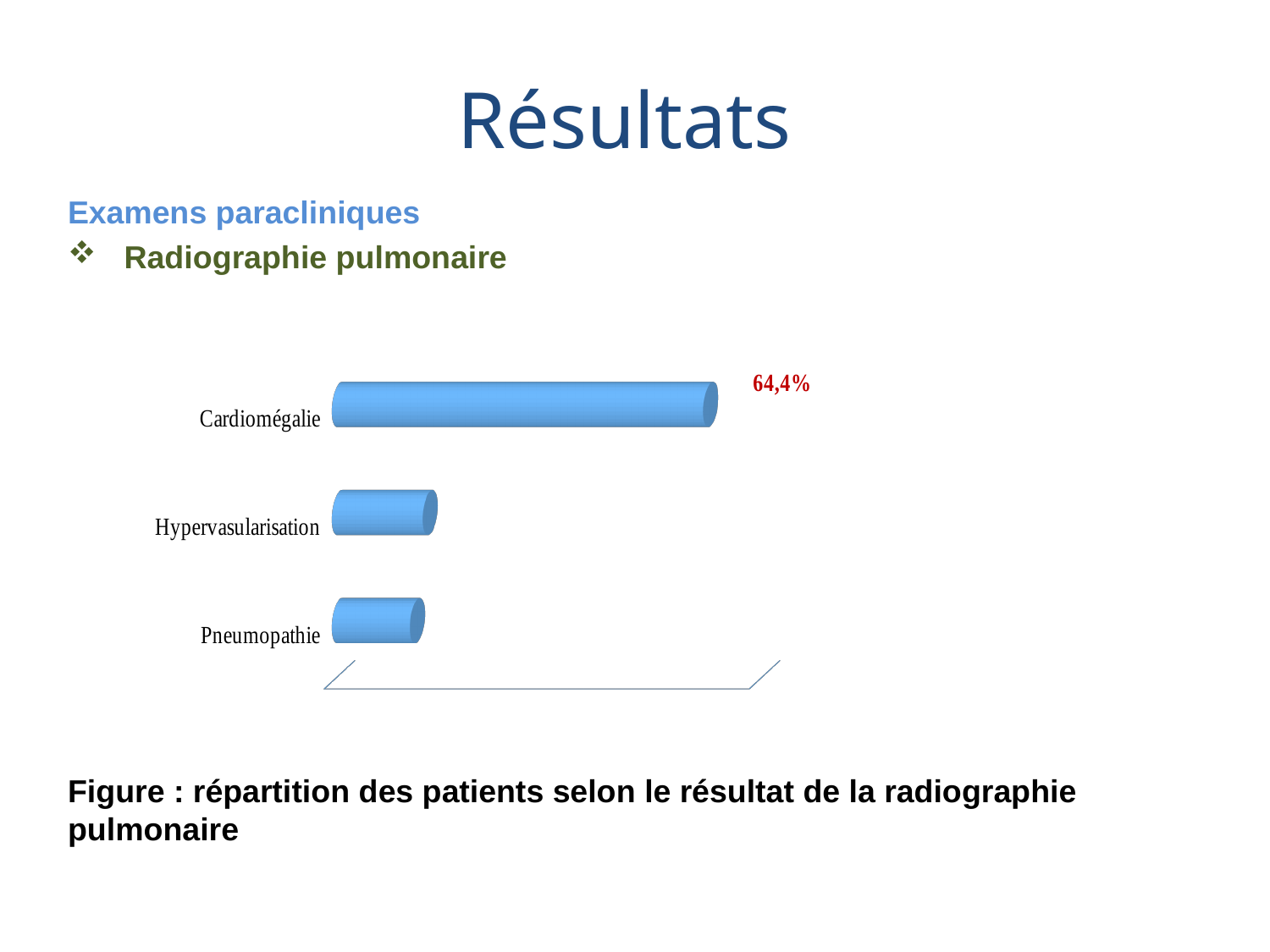
Which is larger, the value for Cardiomégalie or the value for Hypervasularisation? Cardiomégalie What colour are the bars in the chart? Blue Which is larger, the value for Cardiomégalie or the value for Pneumopathie? Cardiomégalie What is the value shown for Cardiomégalie? 64,4% Which category has the highest value? Cardiomégalie How many categories are shown in the chart? 3 Which category is listed at the top of the chart? Cardiomégalie What kind of chart is shown on the slide? Bar chart